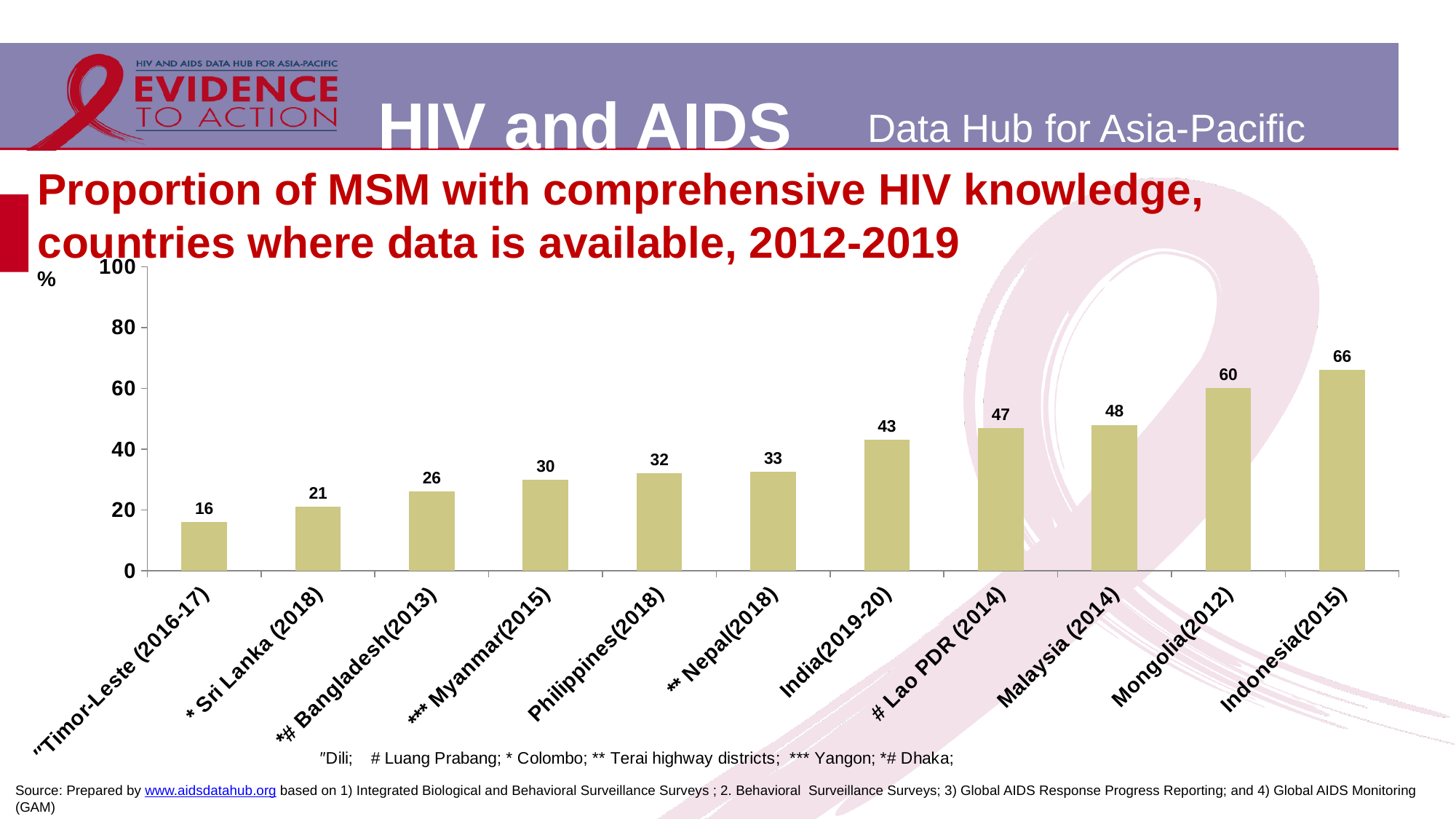
Which country has the lowest proportion of MSM with comprehensive HIV knowledge? Timor-Leste (2016-17) Which is larger, the value for Malaysia (2014) or the value for India (2019-20)? Malaysia (2014) What kind of chart is shown on the slide? bar chart What is the difference between the values for Mongolia (2012) and Sri Lanka (2018)? 39 How many countries are shown in the chart? 11 Do the values rise or fall from left to right across the chart? rise Is the value for Nepal (2018) greater or less than 40? less What unit is shown on the y axis of the chart? % What is the value for Philippines (2018)? 32 What is the value for Lao PDR (2014)? 47 Which country has the highest proportion of MSM with comprehensive HIV knowledge? Indonesia (2015) What is the value for Indonesia (2015)? 66